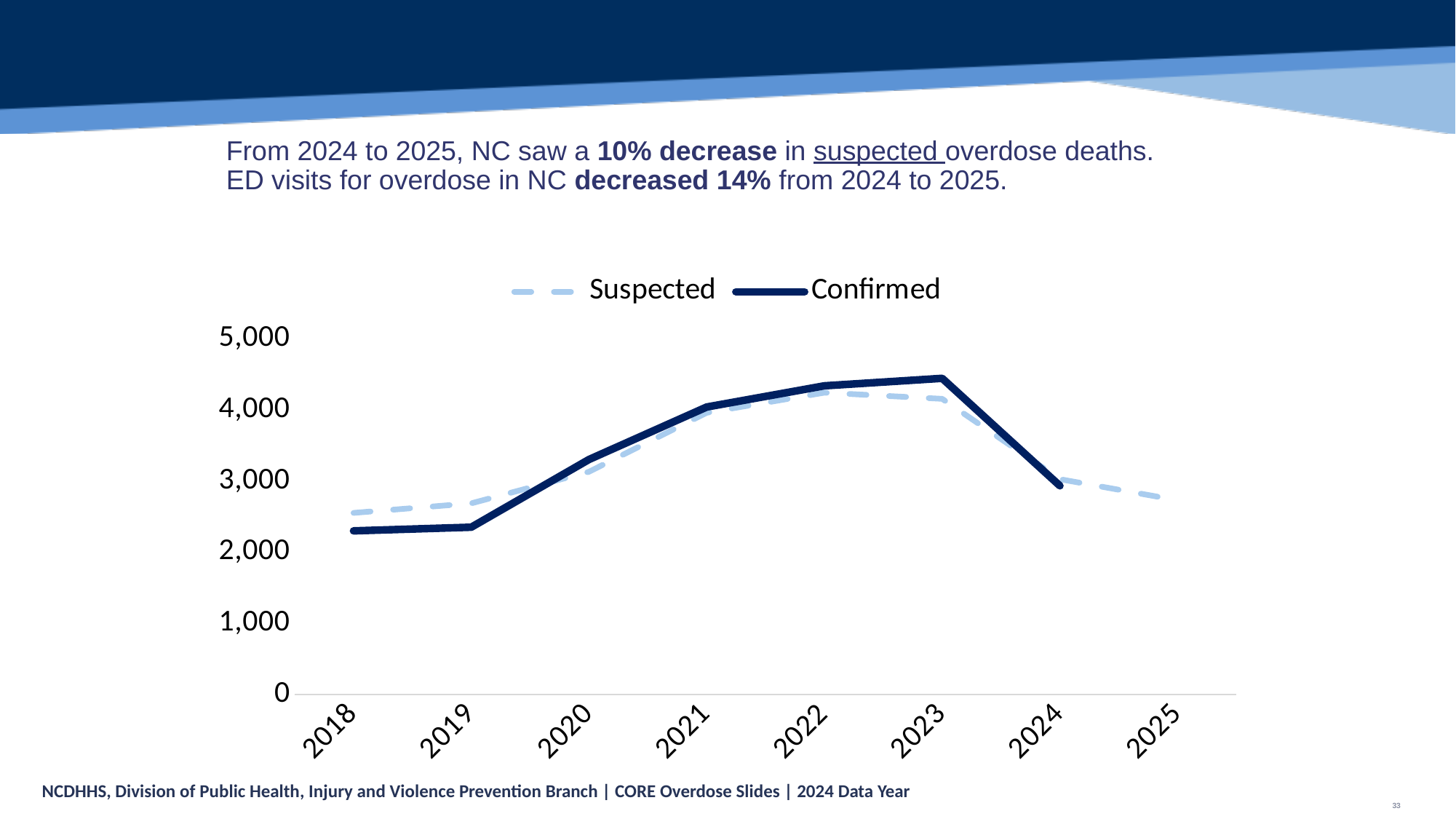
What kind of chart is shown on the slide? line chart Is the Suspected value for 2020 greater or less than 3,000? greater In which year does the Confirmed series reach its highest value? 2023 Is the Suspected value for 2025 greater or less than 3,000? less How many series does the legend list? 2 Does the Confirmed series rise or fall from 2019 to 2023? rise Which two series are listed in the legend? Suspected and Confirmed Is the Confirmed value for 2018 greater or less than 2,000? greater How many years are shown on the x axis? 8 Which is larger, the Confirmed value for 2023 or the Confirmed value for 2024? 2023 Which series is drawn with a dashed line? Suspected